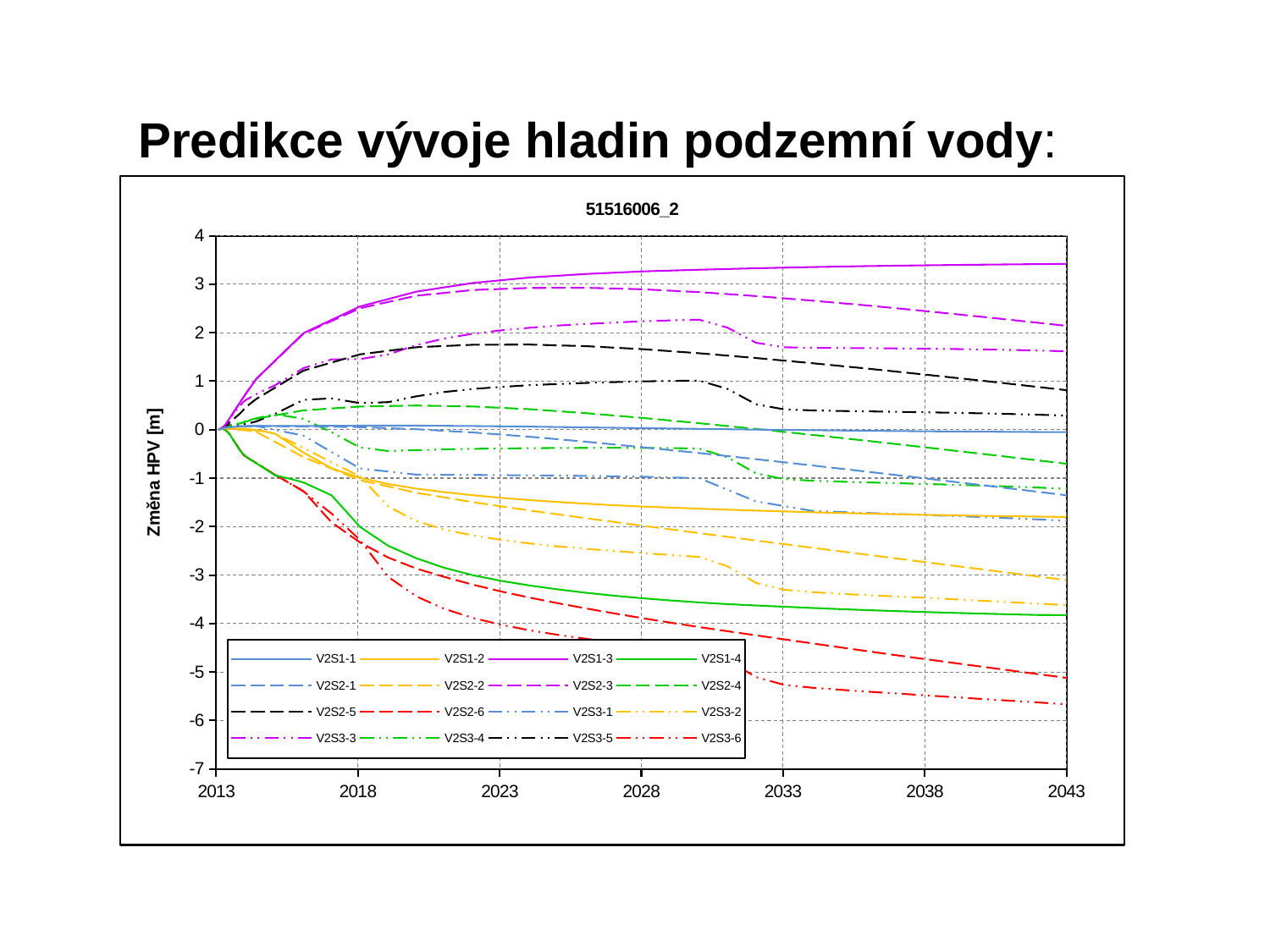
What is the label of the vertical axis? Změna HPV [m] Does the V2S1-3 series rise or fall from 2013 to 2043? rise Is the value for V2S1-4 at 2043 greater or less than -3? less Is the value for V2S3-6 at 2043 greater or less than -5? less What is the title of the chart? 51516006_2 Which series has the lowest value at 2043? V2S3-6 Does the V2S2-6 series rise or fall from 2013 to 2043? fall Is the value for V2S1-3 at 2043 greater or less than 3? greater How many series does the legend of the chart list? 16 At 2043, which series has the larger value, V2S1-4 or V2S2-6? V2S1-4 Which series has the highest value at 2043? V2S1-3 What kind of chart is shown on the slide? line chart